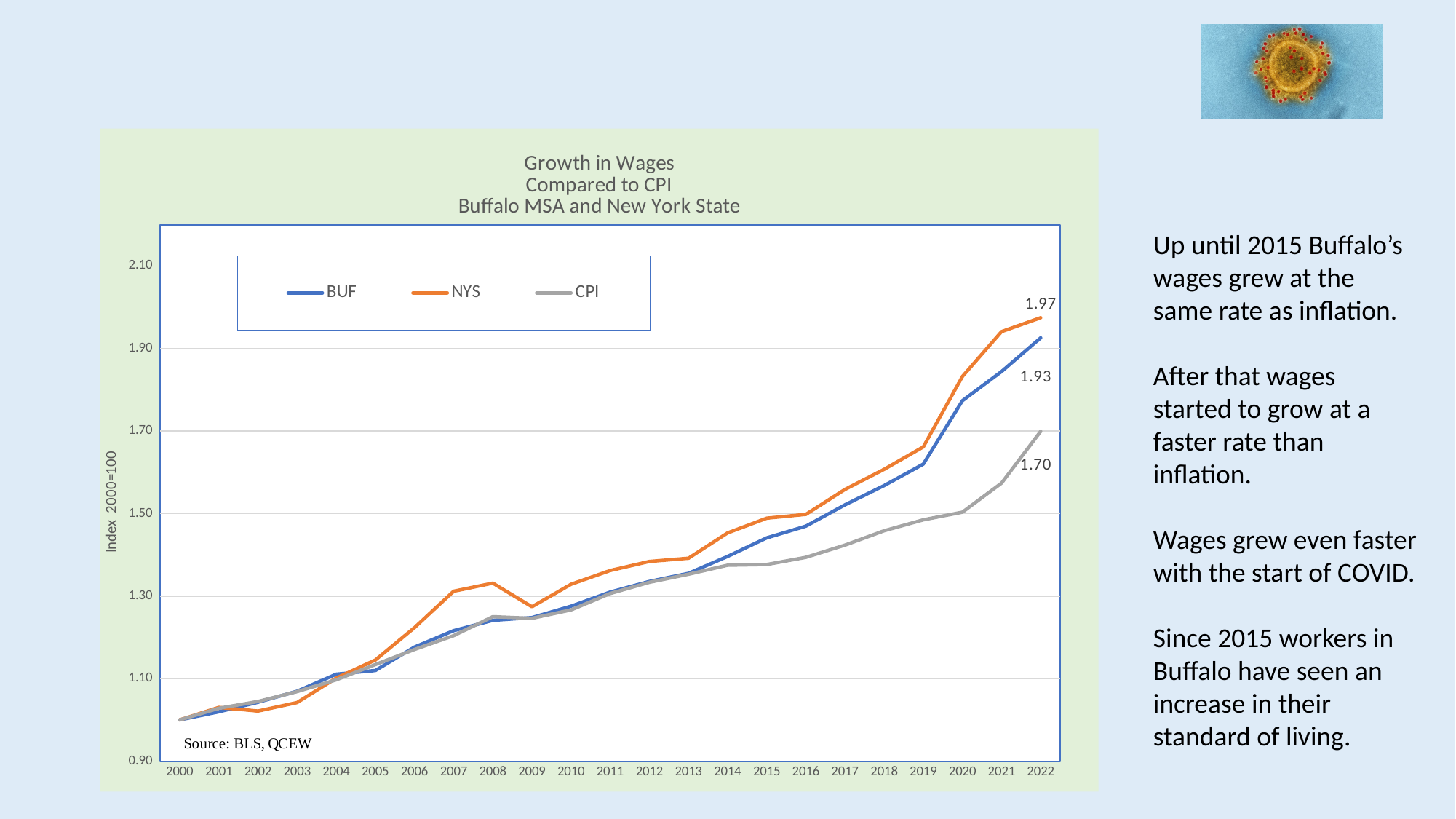
Is the value for NYS in 2020 greater or less than 1.70? greater What is the difference between the NYS and BUF values in 2022? 0.04 What is the value of the BUF series in 2022? 1.93 What is the value of the CPI series in 2022? 1.70 What is the difference between the BUF and CPI values in 2022? 0.23 What is the value of the NYS series in 2022? 1.97 What kind of chart is shown on the slide? Line chart Which series has the highest value in 2022? NYS Is the value for CPI in 2021 greater or less than 1.70? less Which series has the lowest value in 2022? CPI In 2022, which is larger, the BUF value or the CPI value? BUF How many series does the legend list? 3